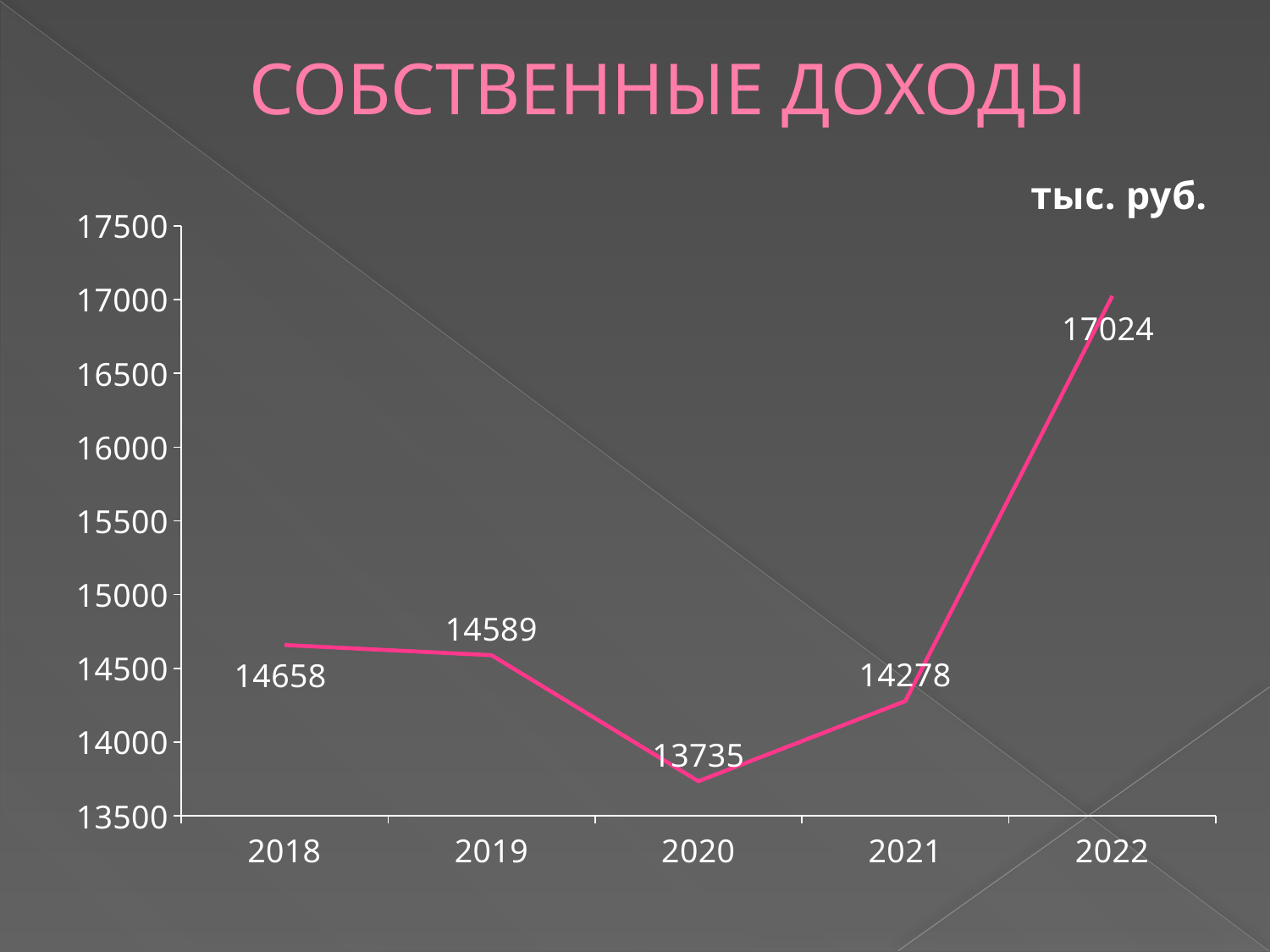
What kind of chart is shown on the slide? line chart Which is larger, the value for 2019 or the value for 2021? 2019 What is the value for 2018? 14658 What is the value for 2020? 13735 What is the difference between the values for 2022 and 2021? 2746 Is the value for 2020 greater or less than 14000? less What is the difference between the values for 2018 and 2019? 69 How many years are plotted on the chart? 5 Which year has the lowest value? 2020 What is the value for 2022? 17024 Which year has the highest value? 2022 What is the value for 2021? 14278